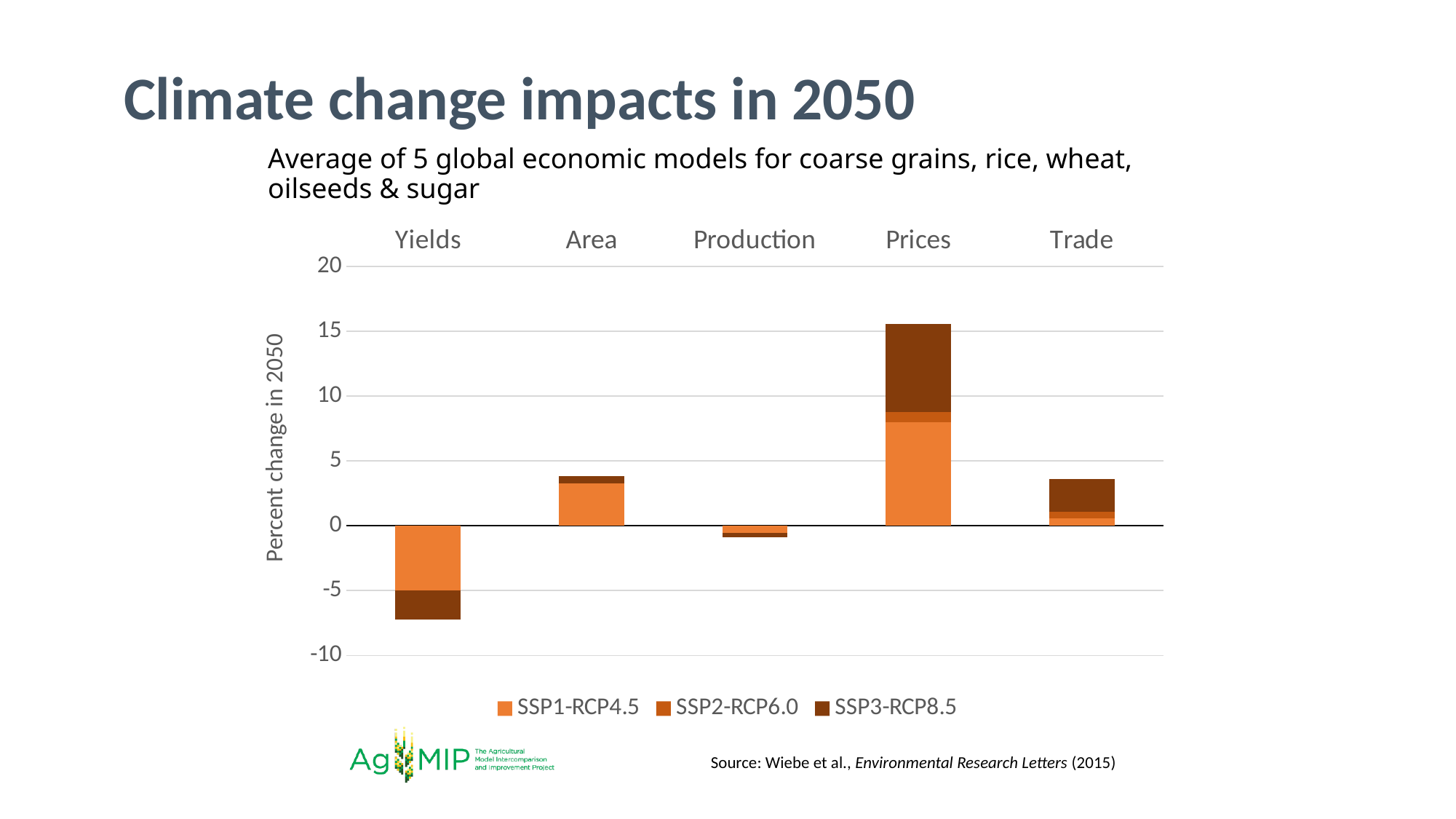
What is the label on the chart's vertical axis? Percent change in 2050 Is the total stacked value for Production greater or less than -5? greater What kind of chart is shown on the slide? Stacked bar chart Which category has the lowest (most negative) stacked bar in the chart? Yields How many categories are shown along the x axis of the chart? 5 Is the total stacked value for Area greater or less than 5? less Which has the larger stacked bar, Prices or Area? Prices Is the total stacked value for Yields greater or less than -5? less How many series does the chart's legend list? 3 Which series is shown in the darkest brown colour in the legend? SSP3-RCP8.5 Which category has the highest stacked bar in the chart? Prices